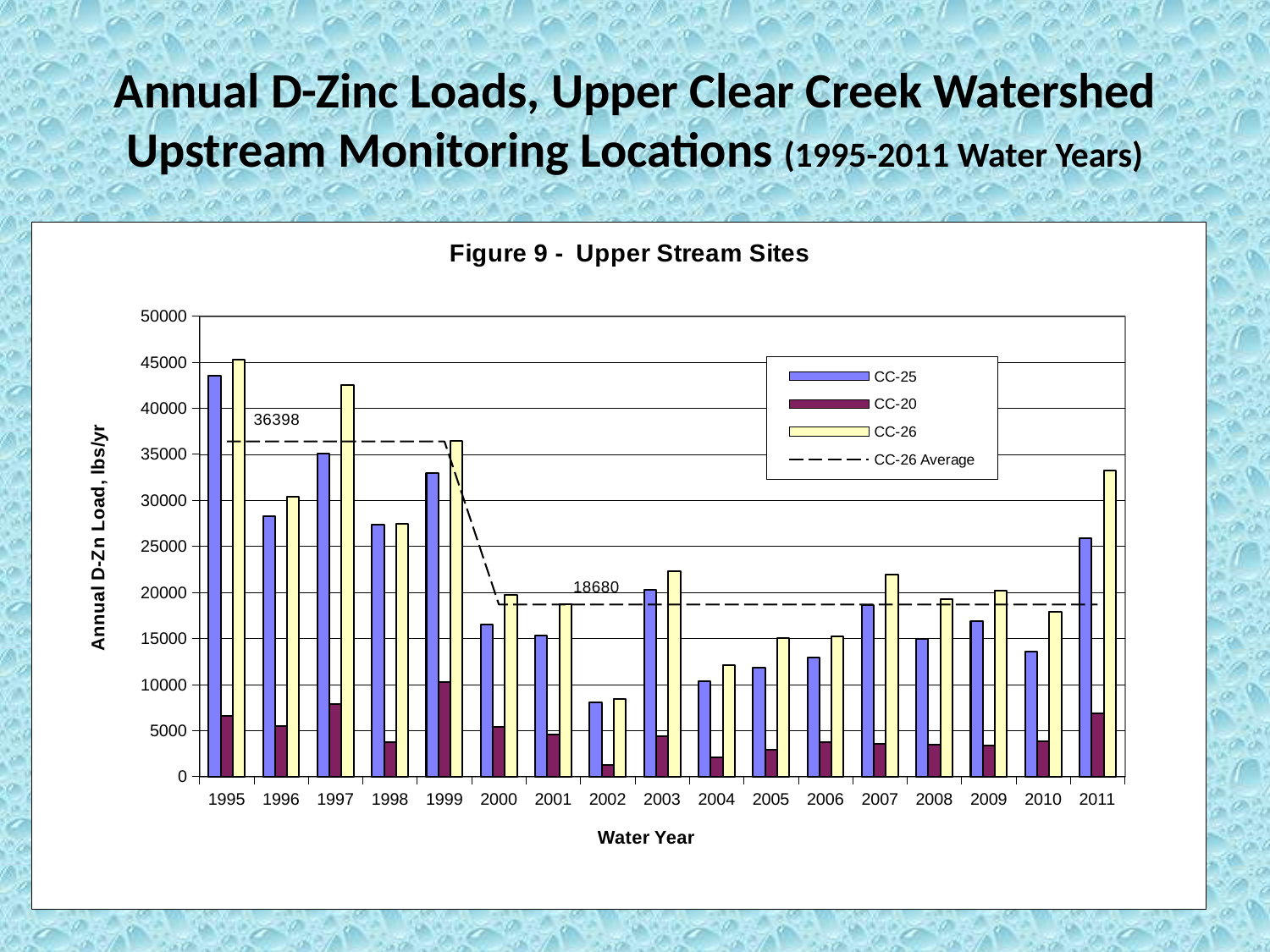
What is the label on the y axis? Annual D-Zn Load, lbs/yr What is the CC-26 Average value labelled for the 1995-1999 period? 36398 How many water years are shown along the x axis? 17 Is the CC-25 value for 2002 greater or less than 10000? less What is the CC-26 Average value labelled for the 2000-2011 period? 18680 In which water year is the CC-25 bar the lowest? 2002 Is the CC-25 value for 1995 greater or less than 40000? greater Which is larger, the CC-25 value for 1995 or for 1996? 1995 How many entries does the legend list? 4 In which water year is the CC-26 bar the highest? 1995 What kind of chart is shown on the slide? Combination bar and line chart (bars with a dashed average line) What is the difference between the two labelled CC-26 Average values, 36398 and 18680? 17718